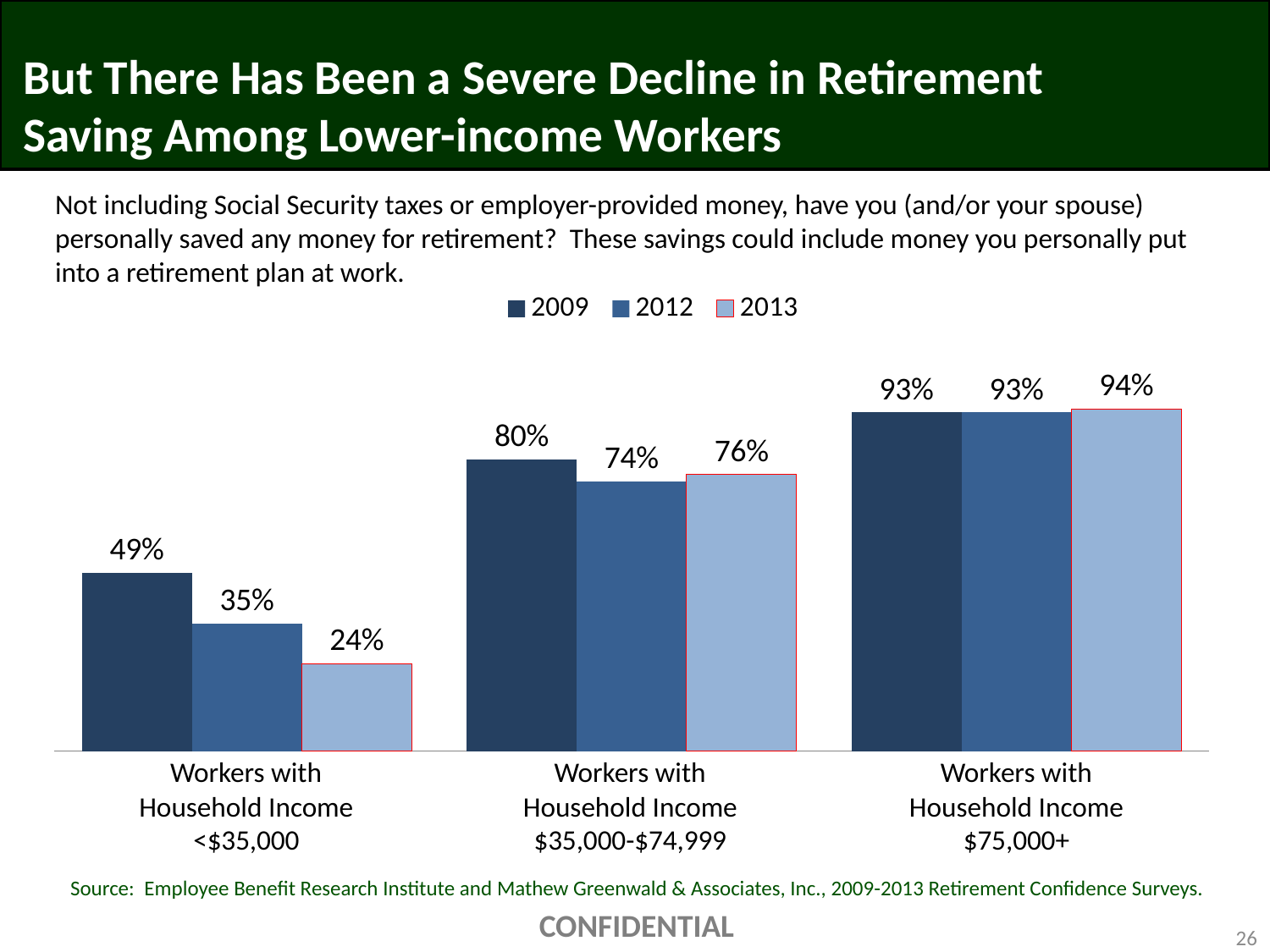
Which income group has the highest 2009 value? Workers with Household Income $75,000+ What is the 2009 value for Workers with Household Income $35,000-$74,999? 80% How many income groups are shown on the x axis? 3 What is the difference between the 2009 and 2012 values for Workers with Household Income $35,000-$74,999? 6% What kind of chart is shown on the slide? Bar chart What is the difference between the 2009 and 2013 values for Workers with Household Income <$35,000? 25% Which income group has the lowest 2013 value? Workers with Household Income <$35,000 How many series does the legend list? 3 What is the 2012 value for Workers with Household Income $75,000+? 93% Which is larger for Workers with Household Income $35,000-$74,999: the 2012 value or the 2013 value? 2013 For Workers with Household Income <$35,000, do the values rise or fall from 2009 to 2013? Fall What is the 2013 value for Workers with Household Income <$35,000? 24%